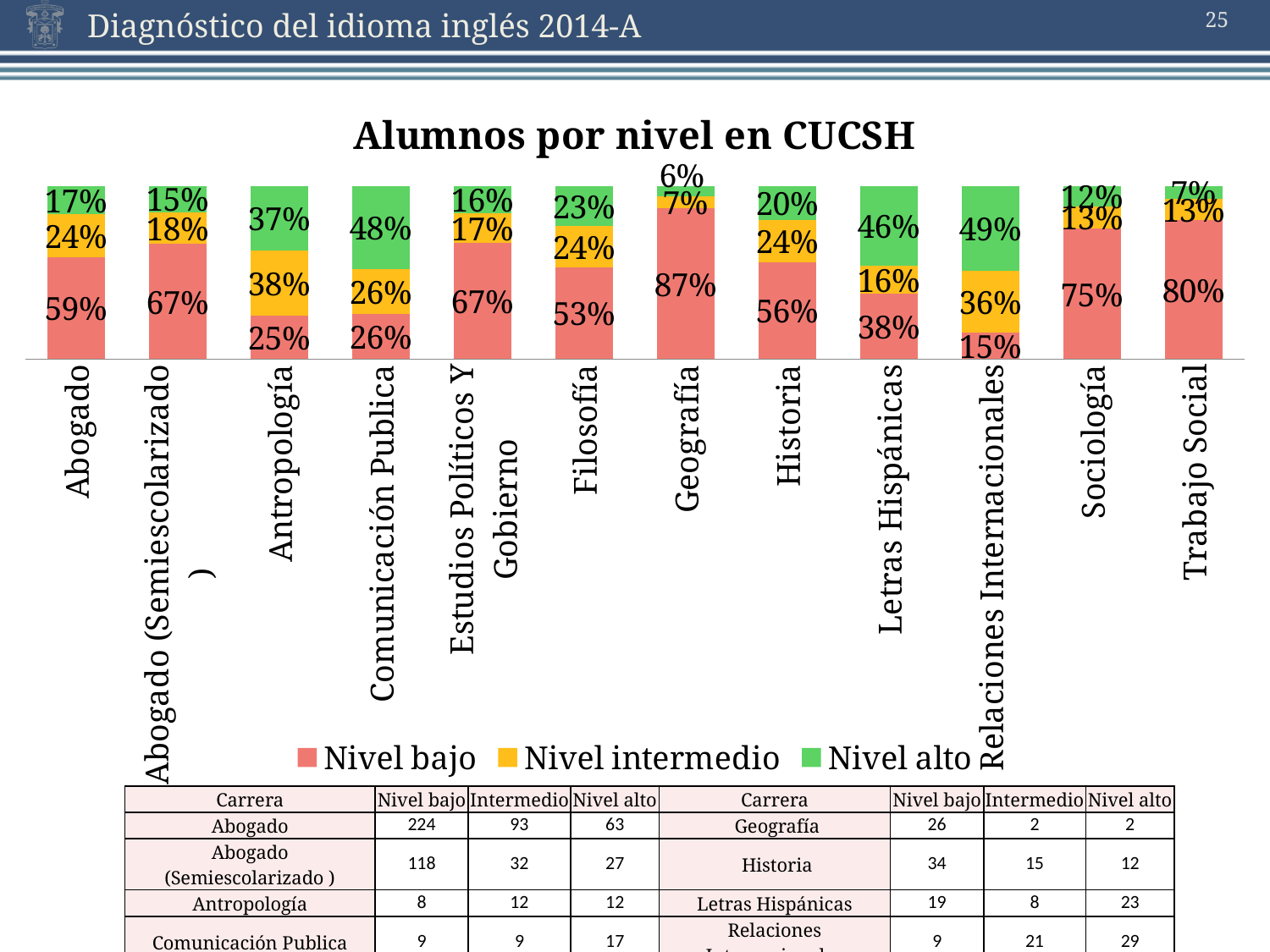
What type of chart is shown on the slide? Stacked bar chart How many series does the legend list? 3 How many categories (carreras) are shown on the x axis of the chart? 12 What is the Nivel alto percentage for Relaciones Internacionales? 49% What is the title of the chart? Alumnos por nivel en CUCSH Which category has the highest Nivel bajo percentage? Geografía What is the Nivel bajo percentage for Geografía? 87% Which category has the lowest Nivel bajo percentage? Relaciones Internacionales Which has a larger Nivel alto percentage, Comunicación Publica or Letras Hispánicas? Comunicación Publica What is the total of the three segments in the Historia bar? 100% What is the difference between the Nivel bajo percentages of Trabajo Social and Sociología? 5% What is the Nivel intermedio percentage for Antropología? 38%